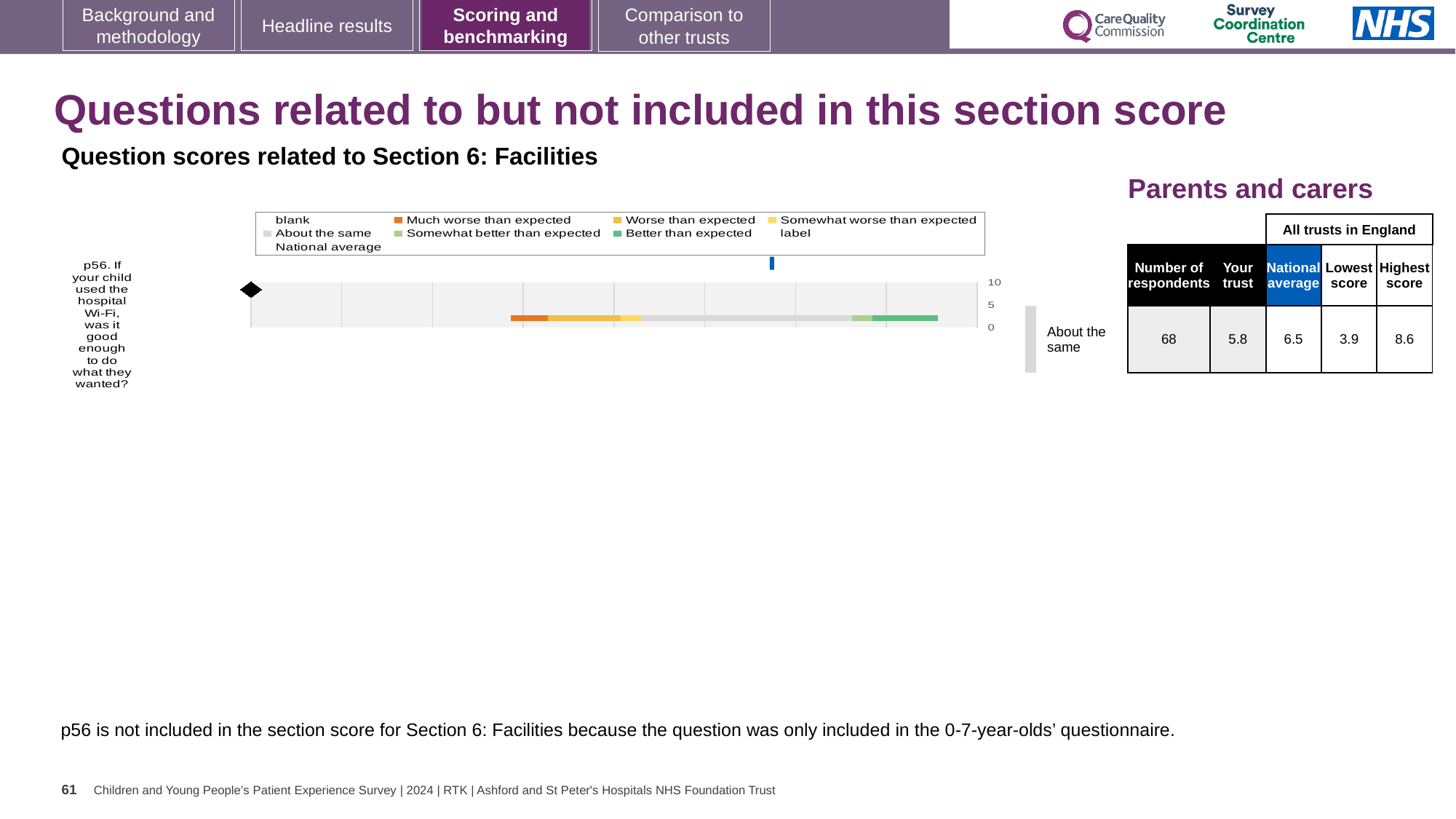
In the table beside the chart, what is the 'Your trust' score for p56? 5.8 How many question categories are plotted in the chart? 1 In the table beside the chart, what is the Lowest score among all trusts in England for p56? 3.9 What is the highest value shown on the chart's numeric axis? 10 What kind of chart is shown on the slide? bar chart In the table beside the chart, how many respondents answered p56? 68 In the table beside the chart, what is the National average score for p56? 6.5 Which is larger for p56, the 'Your trust' score or the National average score? National average Which legend entry is shown in orange? Much worse than expected In the table beside the chart, what is the Highest score among all trusts in England for p56? 8.6 Which question is plotted in the chart? p56. If your child used the hospital Wi-Fi, was it good enough to do what they wanted? How many entries does the chart legend list? 9